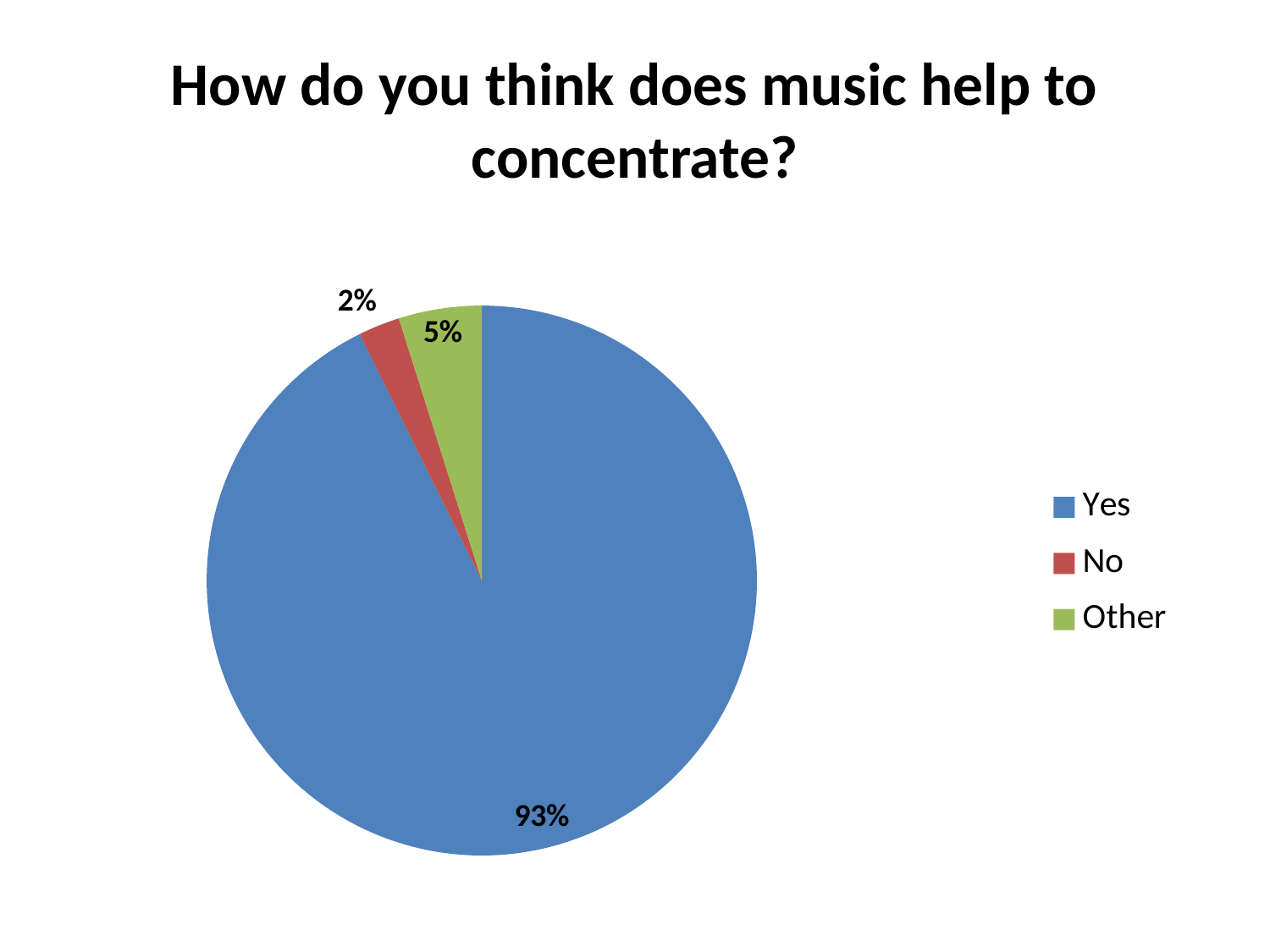
What share of the pie does the "Other" slice represent? 5% What is the difference in percentage points between the "Yes" and "Other" slices? 88 What share of the pie does the "Yes" slice represent? 93% Which category has the smallest slice of the pie? No How many categories are shown in the pie chart? 3 What is the title of the chart? How do you think does music help to concentrate? Which category has the largest slice of the pie? Yes What share of the pie does the "No" slice represent? 2% What kind of chart is shown on the slide? Pie chart Which slice is larger, "No" or "Other"? Other What colour is the "Other" slice in the pie chart? Green What is the difference in percentage points between the "Other" and "No" slices? 3